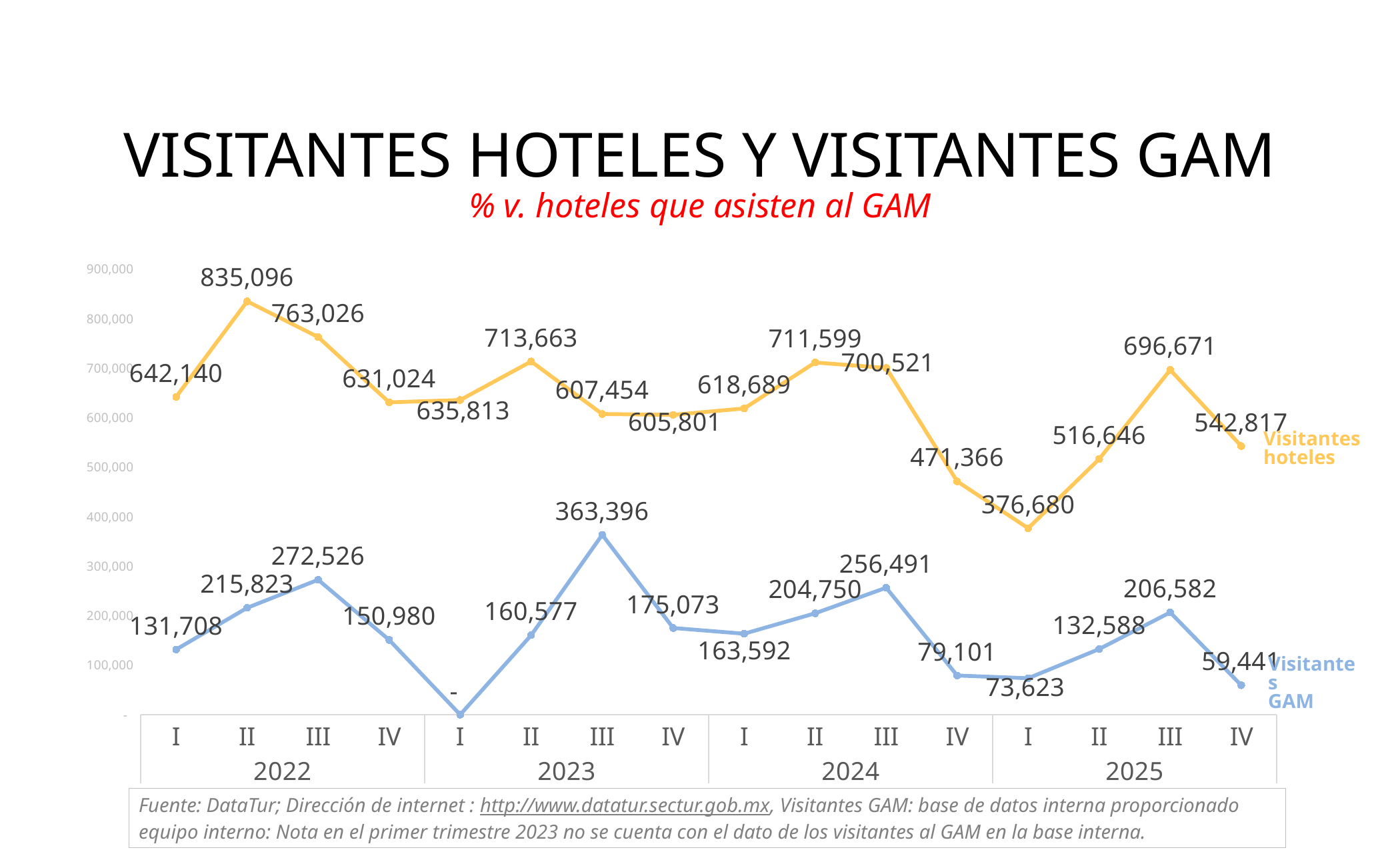
In which quarter does the Visitantes GAM series reach its highest value? III 2023 In which quarter does the Visitantes hoteles series reach its highest value? II 2022 What is the value of Visitantes GAM in quarter III of 2023? 363,396 Which series is drawn in yellow? Visitantes hoteles What is the difference between Visitantes hoteles and Visitantes GAM in quarter II of 2022? 619,273 How many series does the chart show? 2 What is the value of Visitantes hoteles in quarter I of 2025? 376,680 What is the value of Visitantes GAM in quarter IV of 2025? 59,441 In which quarter does the Visitantes hoteles series reach its lowest value? I 2025 What type of chart is shown on the slide? Line chart What is the value of Visitantes hoteles in quarter II of 2022? 835,096 Which is larger: Visitantes hoteles in quarter III of 2025 or Visitantes hoteles in quarter II of 2025? Quarter III of 2025